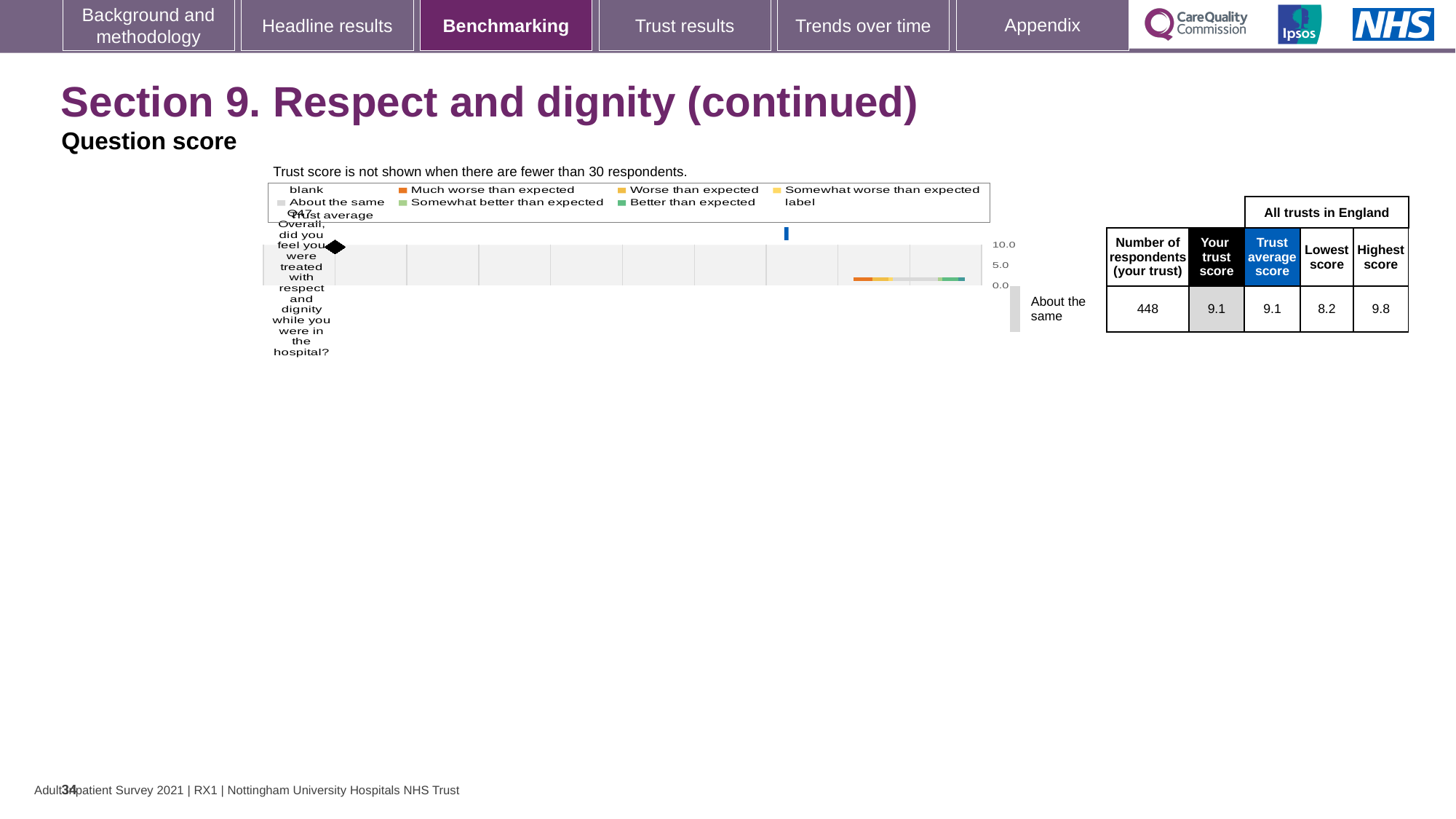
What kind of chart is shown on the slide? bar chart What is the trust score for Q47 (respect and dignity)? 9.1 What is the highest score among all trusts in England for Q47? 9.8 How many respondents from the trust answered Q47? 448 What colour does the legend use for 'Much worse than expected'? orange What is the lowest score among all trusts in England for Q47? 8.2 How much higher is the highest score than the trust's score for Q47? 0.7 What is the trust average score for all trusts in England for Q47? 9.1 Which benchmark category is the trust's Q47 score placed in? About the same Is the trust score for Q47 greater or less than 5.0? greater How many survey questions are plotted in the chart? 1 What is the difference between the highest score and the lowest score for Q47? 1.6